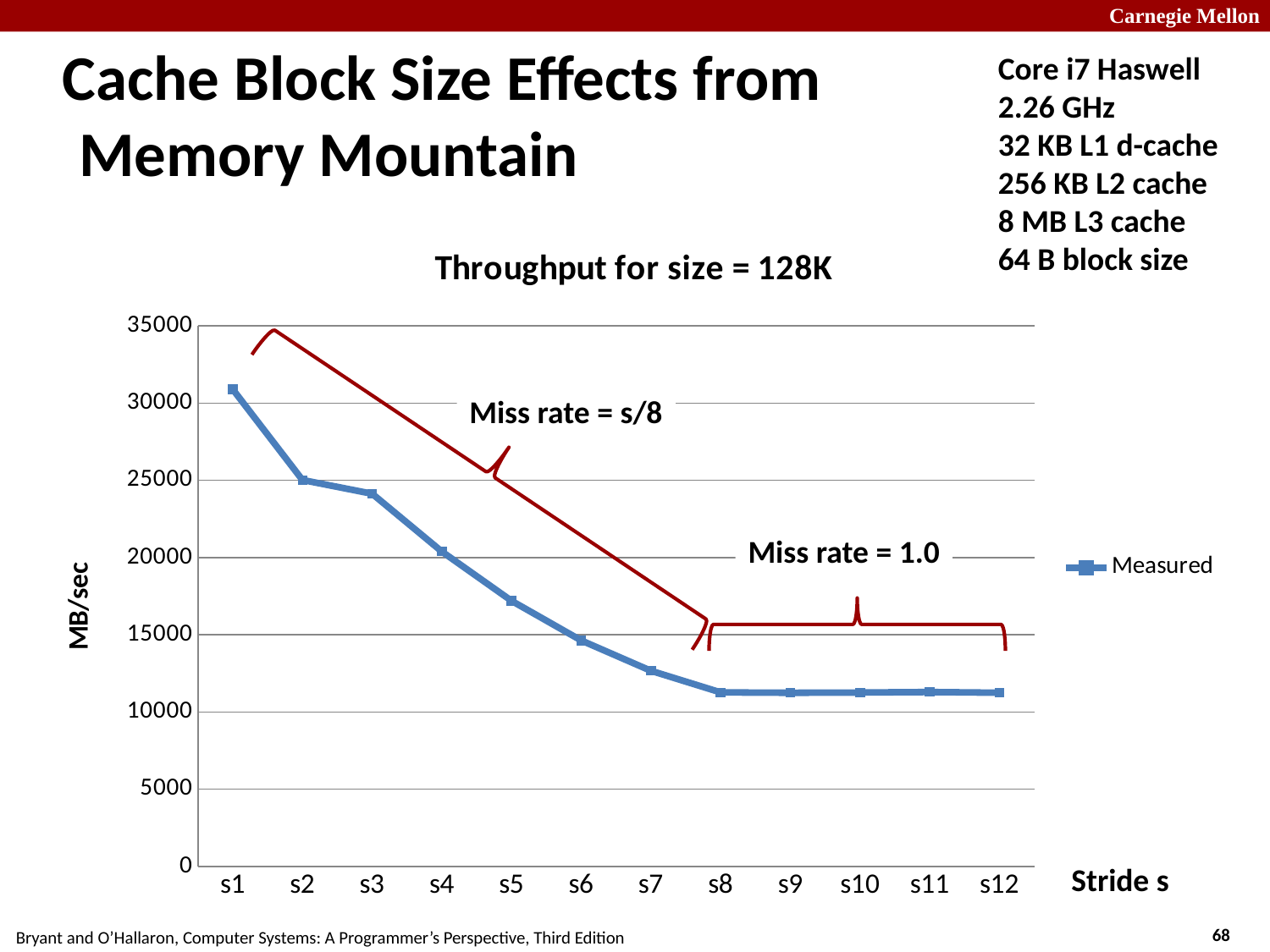
How many series does the chart legend list? 1 Do the measured throughput values rise or fall as the stride increases from s1 to s8? fall Which stride has the larger measured throughput, s4 or s6? s4 How many stride values are plotted along the x axis? 12 Is the measured throughput for s1 greater or less than 30000 MB/sec? greater Is the measured throughput for s3 greater or less than 25000 MB/sec? less Is the measured throughput for s10 greater or less than 10000 MB/sec? greater What is the title of the chart? Throughput for size = 128K Which stride has the highest measured throughput? s1 What kind of chart is shown on the slide? line chart